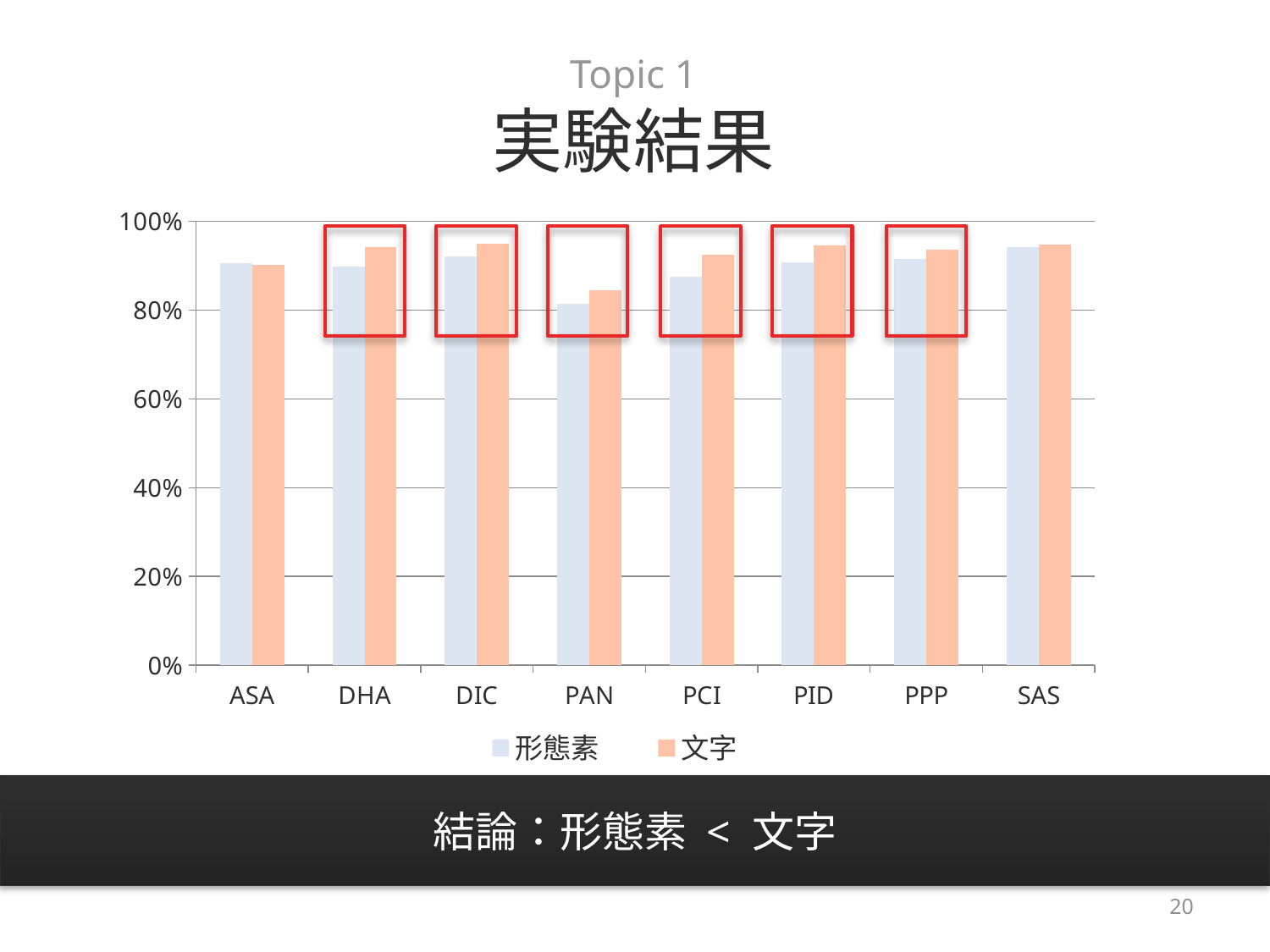
How many series does the chart's legend list? 2 How many categories are shown on the x axis of the chart? 8 For DHA, which series has the larger value, 形態素 or 文字? 文字 Which category has the lowest value for the 形態素 series? PAN What are the two series names listed in the chart's legend? 形態素 and 文字 Which category has the lowest value for the 文字 series? PAN Is the 形態素 value for ASA greater or less than 60%? greater How many categories are highlighted with red boxes on the chart? 6 What kind of chart is shown on the slide? bar chart For PCI, which series has the larger value, 形態素 or 文字? 文字 Is the 文字 value for PAN greater or less than 80%? greater Is the 形態素 value for PCI greater or less than 80%? greater